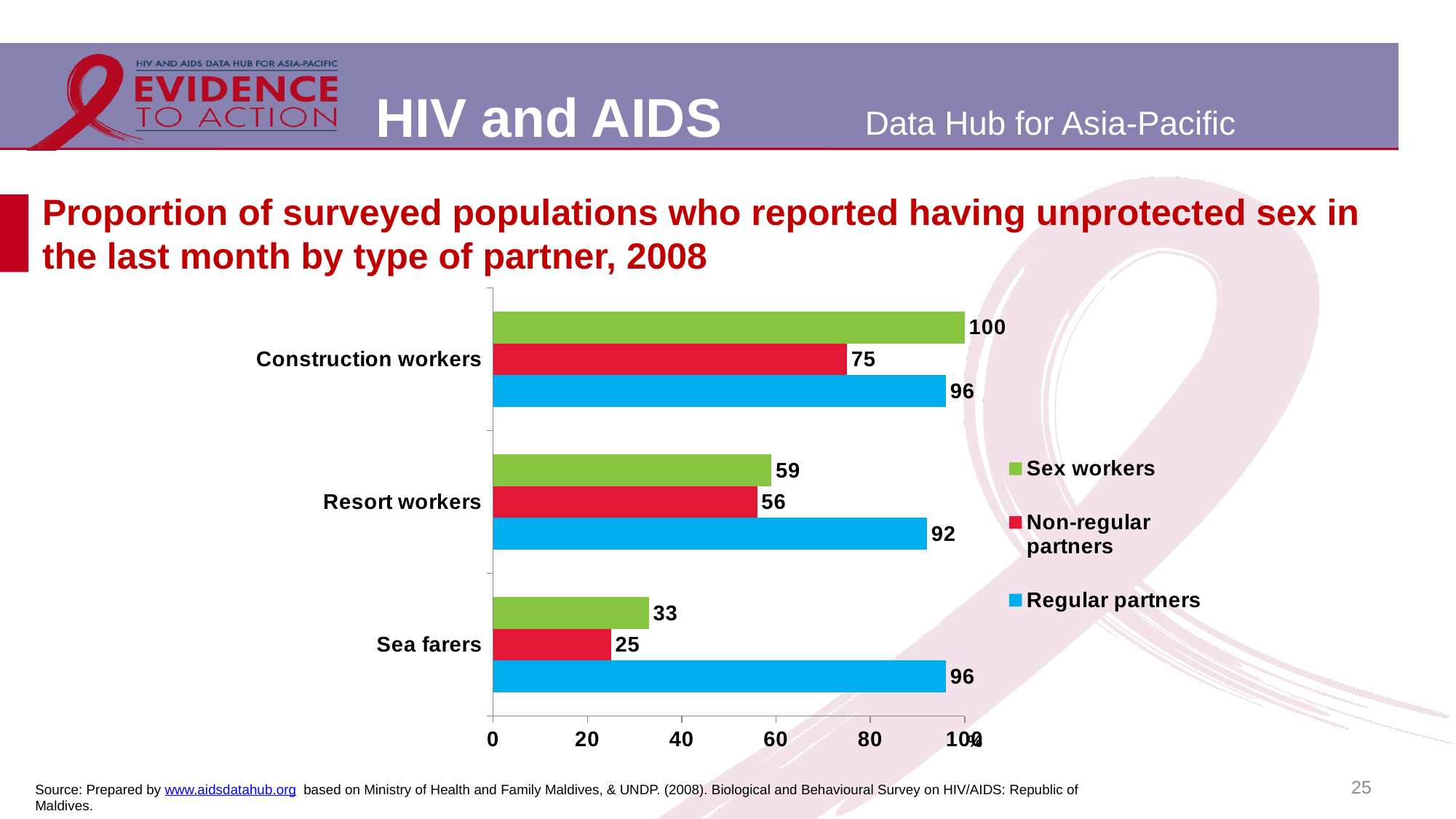
What is the difference between the Sex workers values for Construction workers and Sea farers? 67 Which population group has the lowest value for Non-regular partners? Sea farers How many series does the legend list? 3 Which population group has the highest value for Sex workers? Construction workers What type of chart is shown on the slide? Bar chart Which is larger for Resort workers: the Sex workers value or the Regular partners value? Regular partners What value is shown for Non-regular partners among Resort workers? 56 What value is shown for Regular partners among Sea farers? 96 How many population groups are shown on the chart? 3 What colour represents Regular partners in the chart? Blue What value is shown for Sex workers among Construction workers? 100 What is the difference between the Regular partners and Non-regular partners values for Sea farers? 71